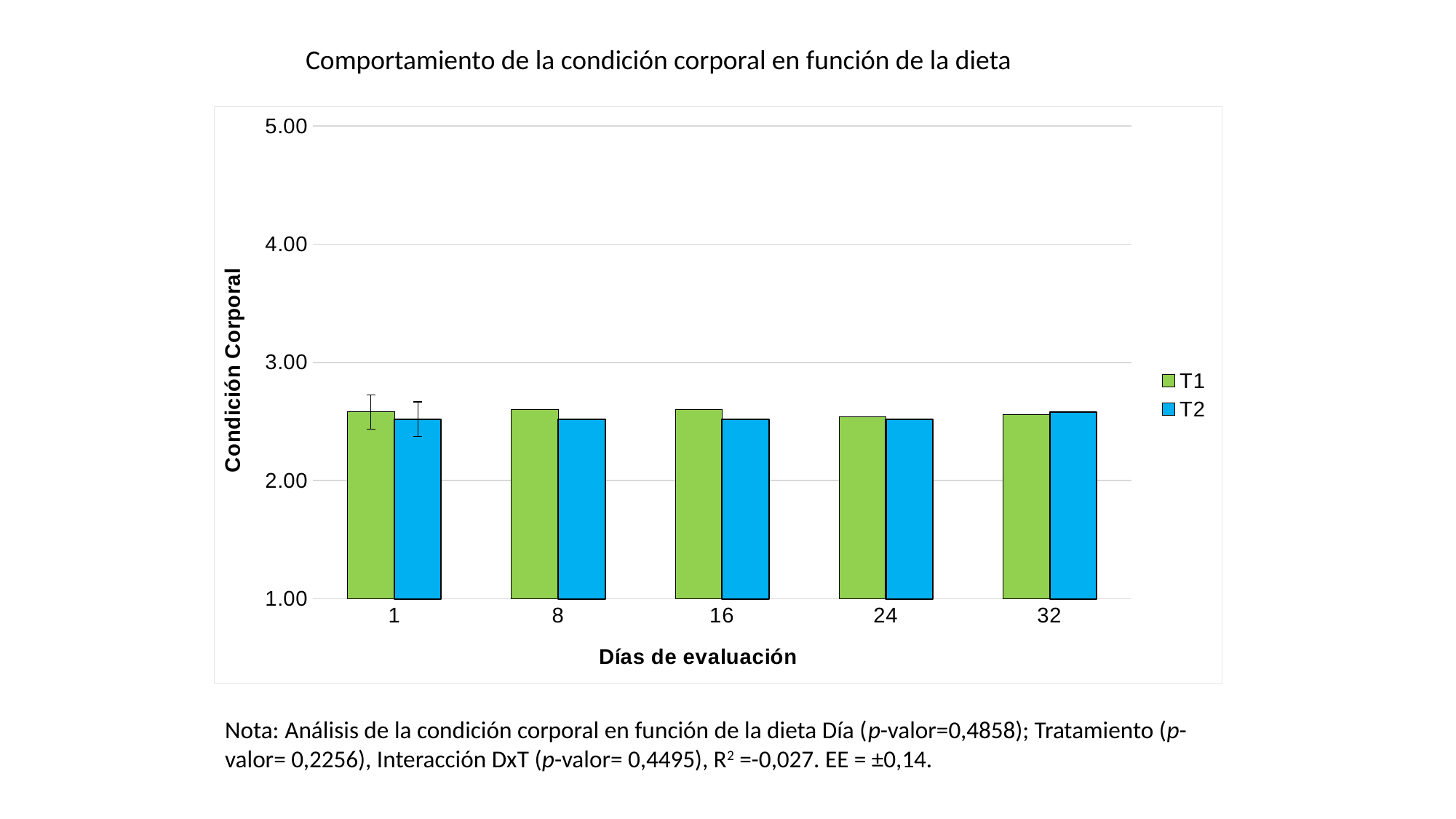
What kind of chart is shown on the slide? bar chart Is the value for T2 on day 8 greater or less than 3.00? less How many series does the legend list? 2 What is the title of the chart? Comportamiento de la condición corporal en función de la dieta How many evaluation-day categories are shown on the x axis? 5 What are the two series named in the legend? T1 and T2 Is the value for T1 on day 32 greater or less than 4.00? less What is the label of the x axis? Días de evaluación Is the value for T2 on day 24 greater or less than 2.00? greater